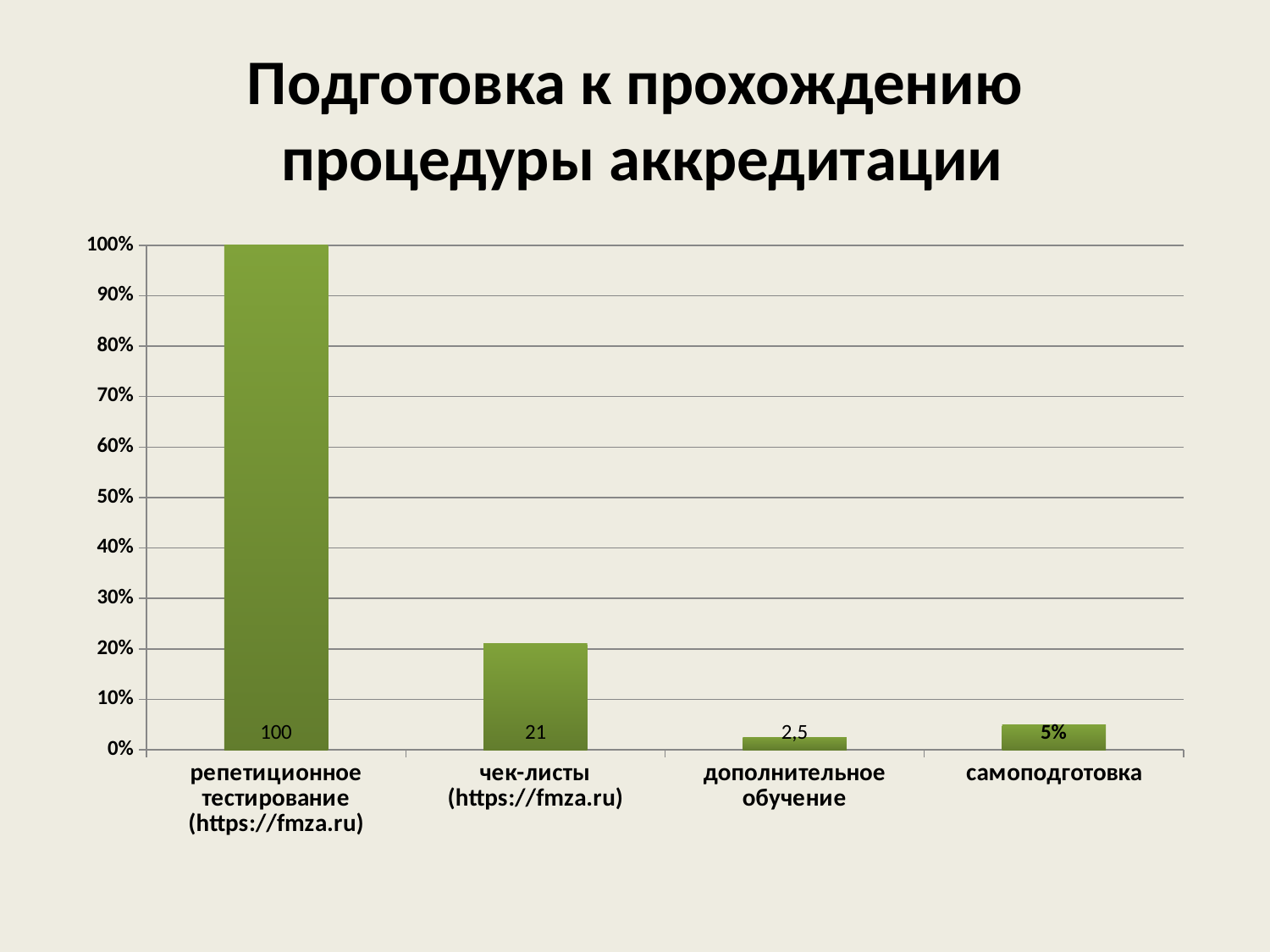
What value is shown for самоподготовка? 5% What is the title of the slide? Подготовка к прохождению процедуры аккредитации How many categories are shown on the x axis? 4 Which is larger, the value for чек-листы (https://fmza.ru) or the value for самоподготовка? чек-листы (https://fmza.ru) Which category has the lowest value? дополнительное обучение What kind of chart is shown on the slide? bar chart Is the value for чек-листы (https://fmza.ru) greater or less than 30%? less What value is shown for дополнительное обучение? 2,5 Which category has the highest value? репетиционное тестирование (https://fmza.ru) What value is shown for чек-листы (https://fmza.ru)? 21 What value is shown for репетиционное тестирование (https://fmza.ru)? 100 What is the difference between the values for репетиционное тестирование (https://fmza.ru) and чек-листы (https://fmza.ru)? 79